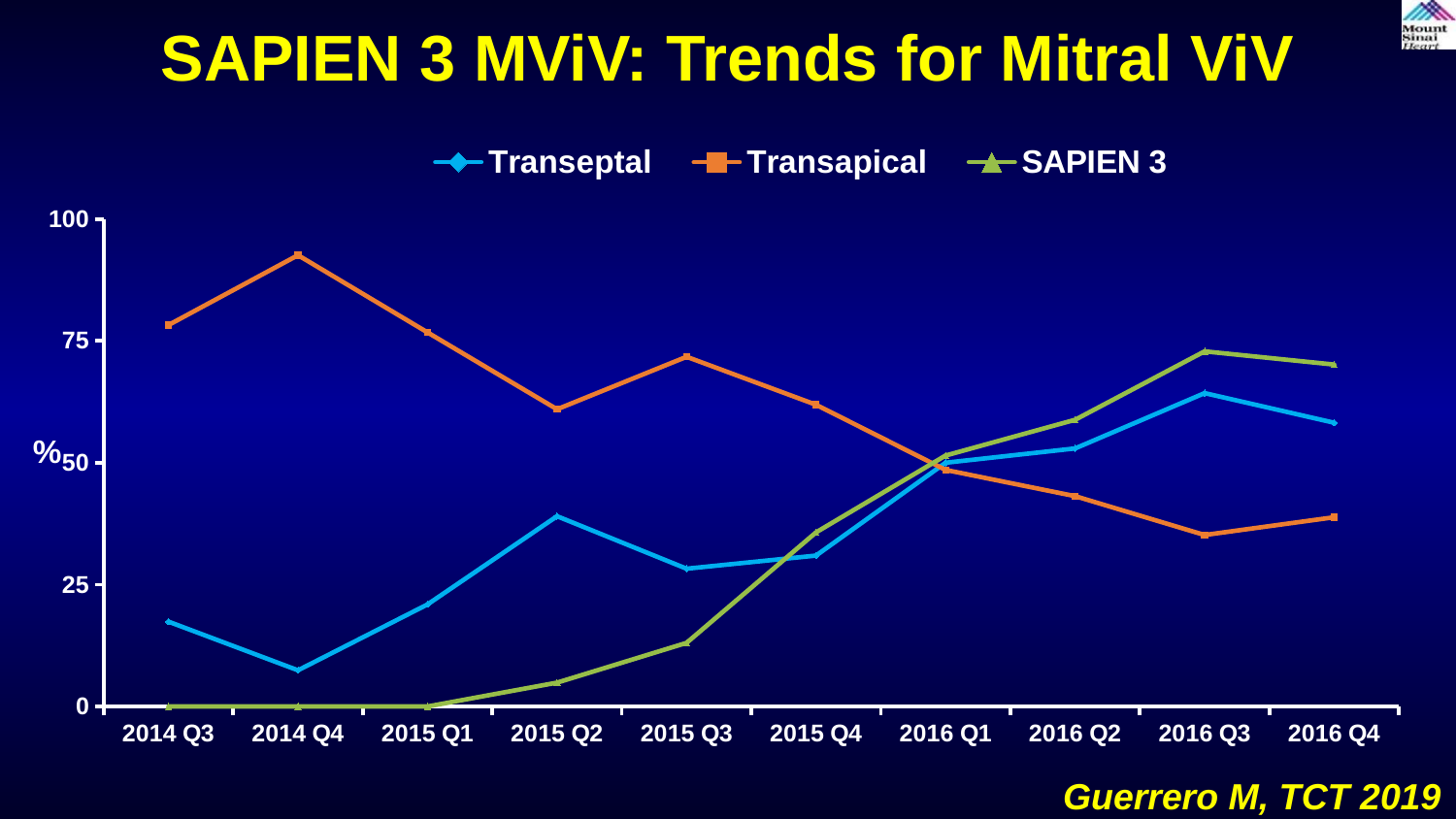
How many series does the legend list? 3 What is the value for SAPIEN 3 in 2014 Q3? 0 Which series has the higher value in 2016 Q3, Transapical or SAPIEN 3? SAPIEN 3 How many quarters are plotted along the x axis? 10 Does the Transapical series generally rise or fall from 2014 Q4 to 2016 Q3? fall In which quarter does the Transeptal series reach its lowest value? 2014 Q4 What kind of chart is shown on the slide? line chart Is the value for Transeptal in 2015 Q3 greater or less than 50? less What is the value for SAPIEN 3 in 2015 Q1? 0 In which quarter does the Transapical series reach its highest value? 2014 Q4 Is the value for Transapical in 2014 Q4 greater or less than 75? greater What is the title of the chart? SAPIEN 3 MViV: Trends for Mitral ViV